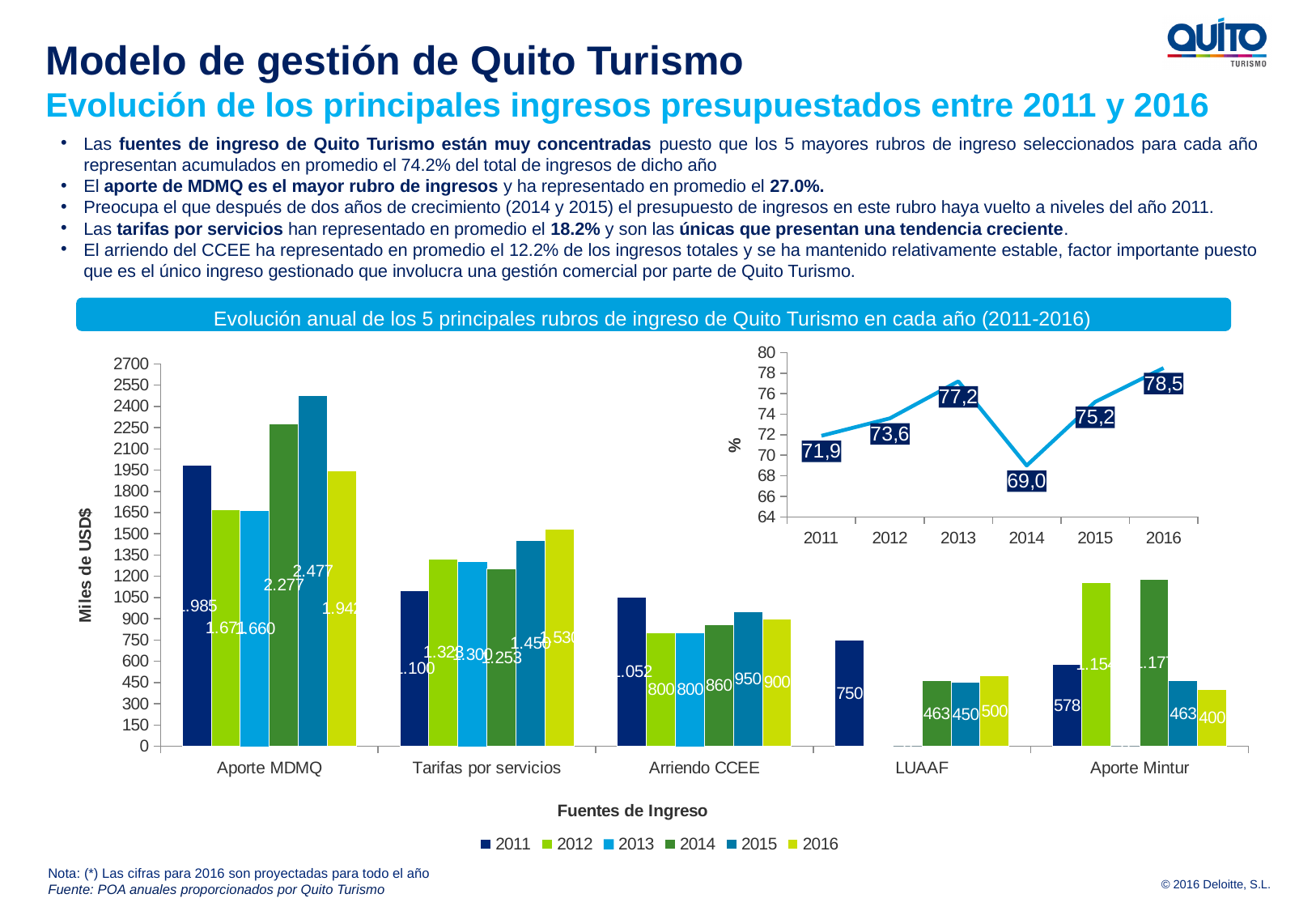
In the bar chart, how many series does the legend list? 6 In the bar chart, is the 2015 value for Aporte MDMQ greater or less than 2400? greater In the line chart at the top right, what is the value for 2016? 78,5 In the bar chart, what is the 2015 value for Aporte MDMQ? 2.477 In the line chart at the top right, does the value rise or fall from 2014 to 2016? rise In the bar chart, what is the difference between the 2016 and 2015 values for Tarifas por servicios? 80 In the line chart at the top right, which year has the lowest value? 2014 In the bar chart, what is the 2016 value for Tarifas por servicios? 1.530 In the line chart at the top right, how many data points are plotted? 6 In the bar chart, which is larger for Arriendo CCEE: the 2015 value or the 2016 value? 2015 In the line chart at the top right, what is the difference between the 2016 value and the 2014 value? 9,5 In the line chart at the top right, which year has the highest value? 2016